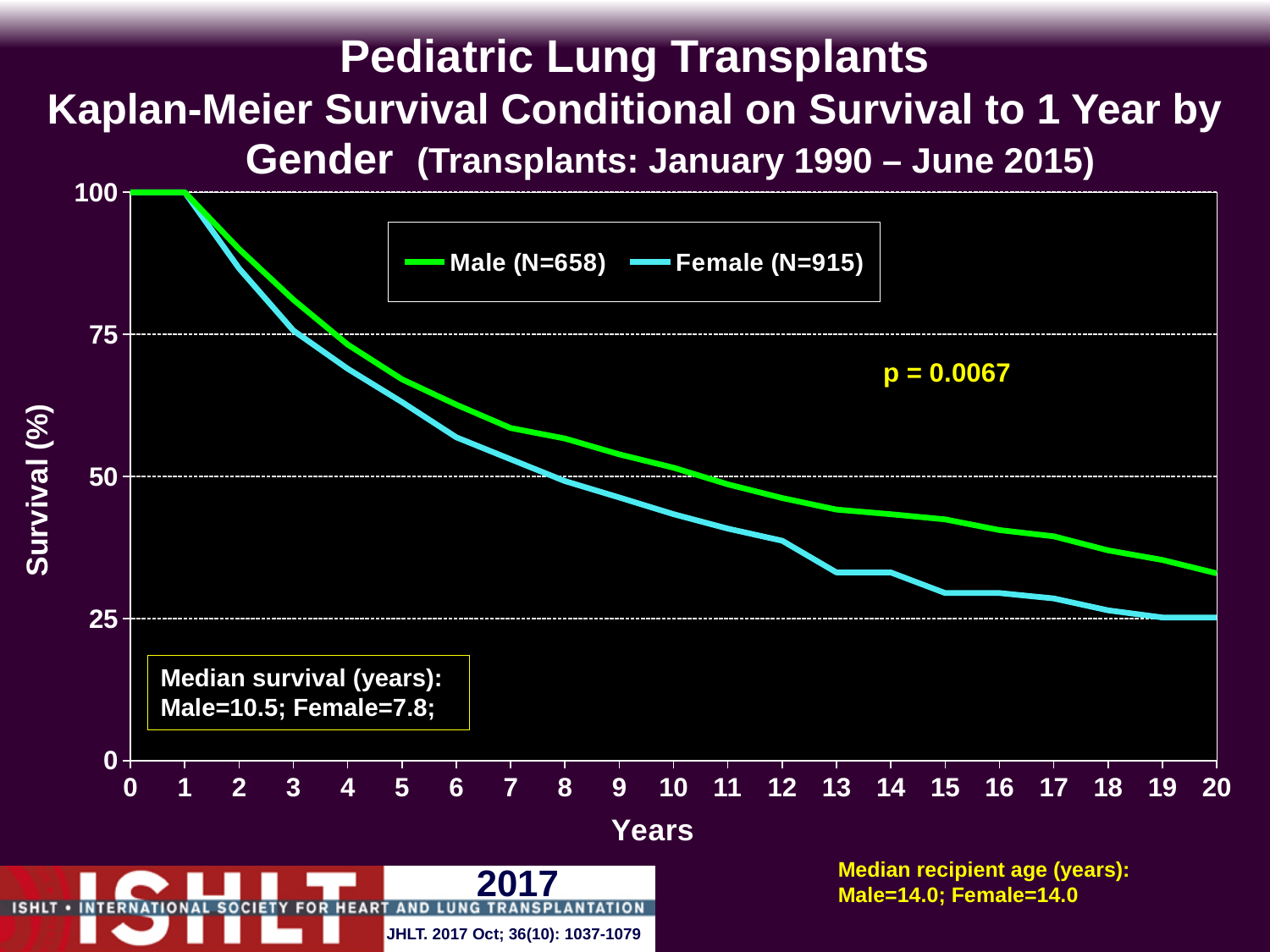
At 10 years, which series shows higher survival, Male or Female? Male Is the survival value for the Female series at 13 years greater or less than 50? less Is the survival value for the Male series at 5 years greater or less than 50? greater What is the median survival in years for females, as printed on the slide? 7.8 What is the median survival in years for males, as printed on the slide? 10.5 Which group has the longer median survival, males or females? Male Do the survival curves rise or fall as years increase? fall What is the p-value shown on the chart? p = 0.0067 What kind of chart is shown on the slide? line chart How many male patients (N) are in the Male series according to the legend? 658 What is the difference in median survival (years) between males and females? 2.7 How many series does the legend list? 2